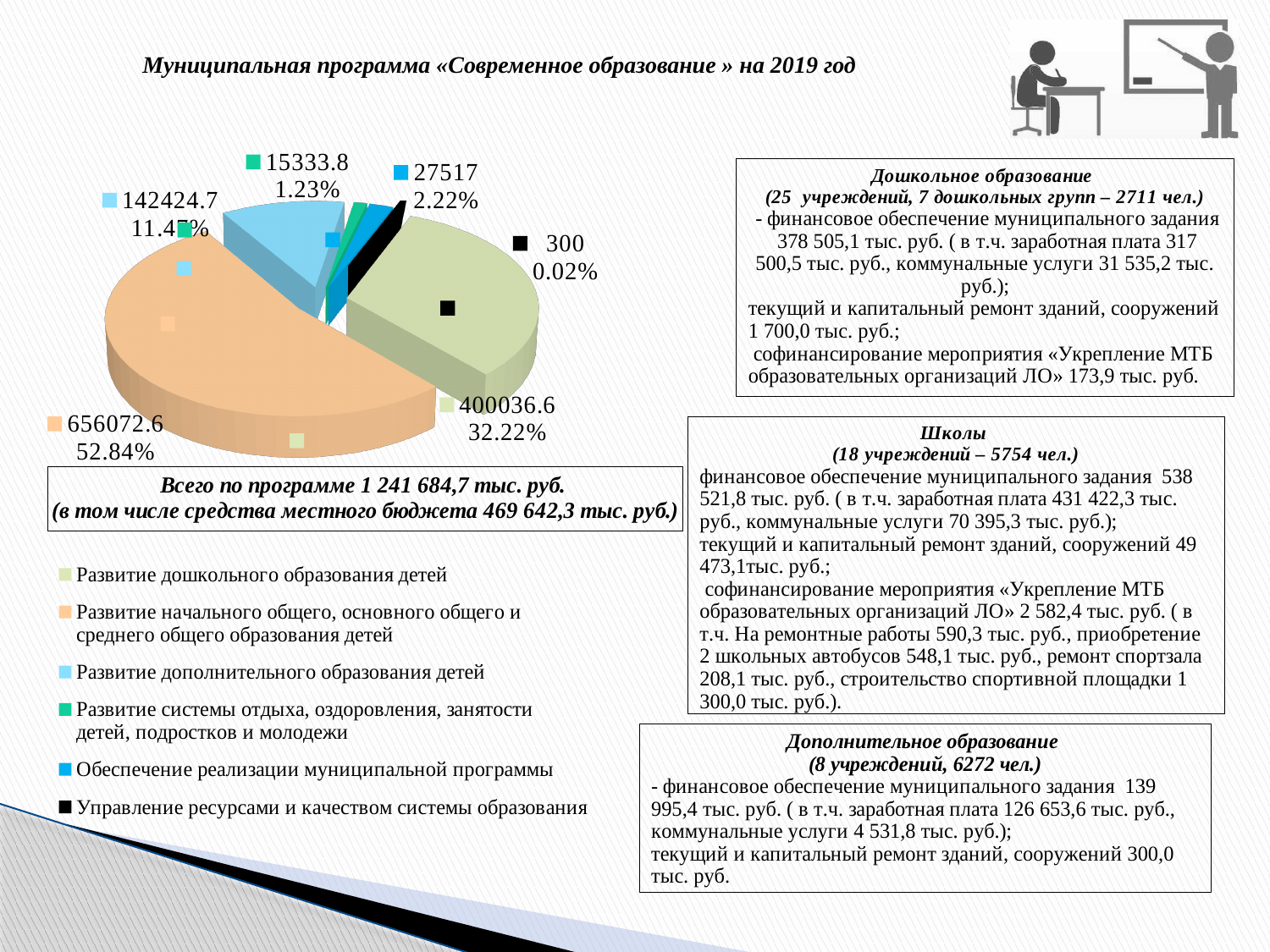
What is the difference between the values for «Развитие начального общего, основного общего и среднего общего образования детей» and «Развитие дошкольного образования детей» in the pie chart? 256036 How many categories does the pie chart's legend list? 6 What percentage share does «Развитие системы отдыха, оздоровления, занятости детей, подростков и молодежи» have in the pie chart? 1.23% What percentage share does «Обеспечение реализации муниципальной программы» have in the pie chart? 2.22% What is the value shown for «Развитие дополнительного образования детей» in the pie chart? 142424.7 Which category has the smallest slice in the pie chart? Управление ресурсами и качеством системы образования Which is larger in the pie chart: «Развитие системы отдыха, оздоровления, занятости детей, подростков и молодежи» or «Обеспечение реализации муниципальной программы»? Обеспечение реализации муниципальной программы What is the value shown for «Развитие начального общего, основного общего и среднего общего образования детей» in the pie chart? 656072.6 What percentage share does «Развитие дошкольного образования детей» have in the pie chart? 32.22% What is the value shown for «Управление ресурсами и качеством системы образования» in the pie chart? 300 Which category has the largest slice in the pie chart? Развитие начального общего, основного общего и среднего общего образования детей What type of chart is shown on the slide? Pie chart